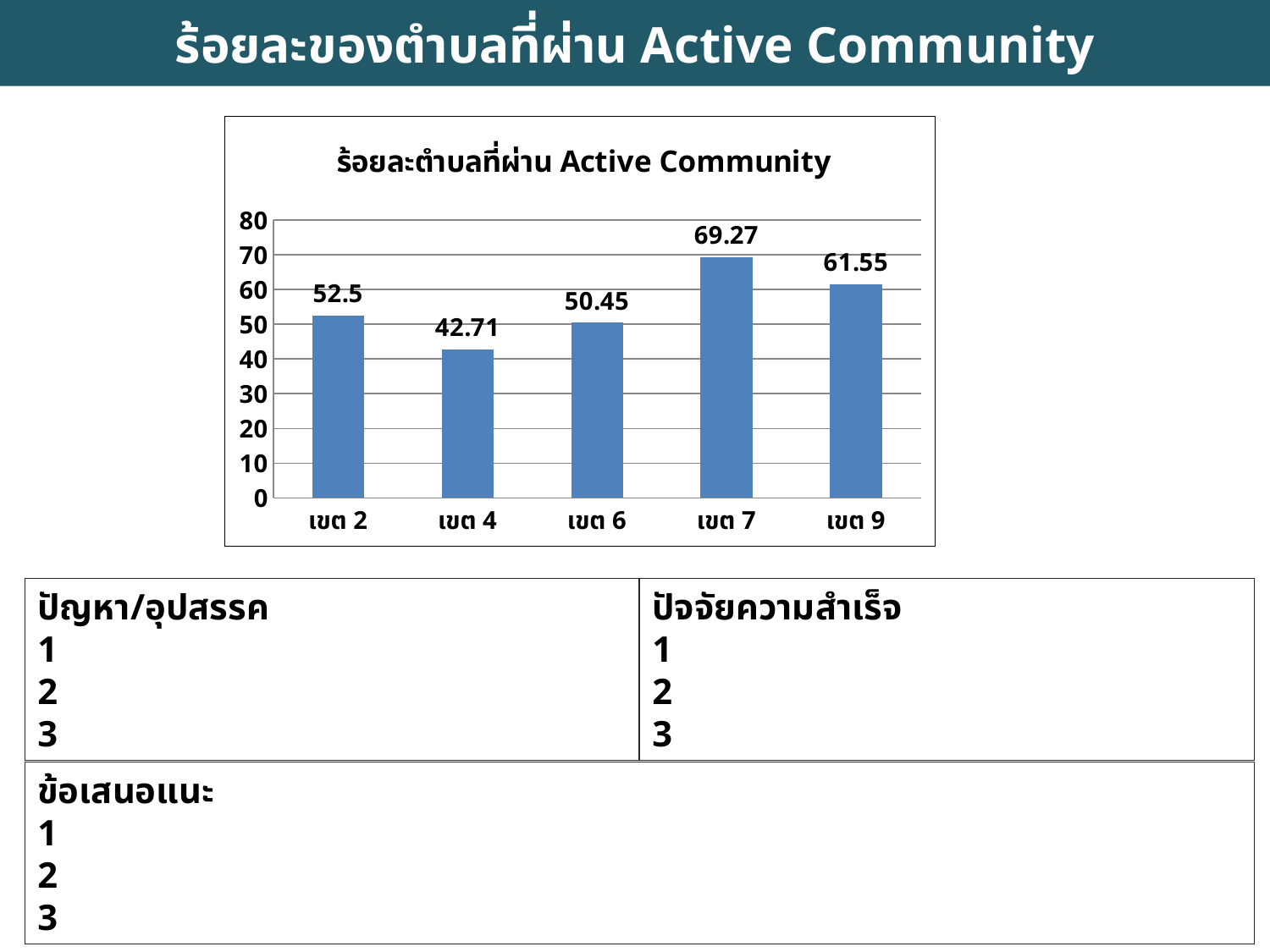
What is the difference between the values for เขต 7 and เขต 4? 26.56 What is the title of the chart? ร้อยละตำบลที่ผ่าน Active Community Which category has the highest value? เขต 7 Which is larger, the value for เขต 2 or the value for เขต 6? เขต 2 How many categories are shown on the x axis? 5 What is the value for เขต 4? 42.71 What is the value for เขต 2? 52.5 What is the value for เขต 9? 61.55 What kind of chart is shown on the slide? bar chart What is the value for เขต 7? 69.27 Is the value for เขต 9 greater or less than 50? greater Which category has the lowest value? เขต 4